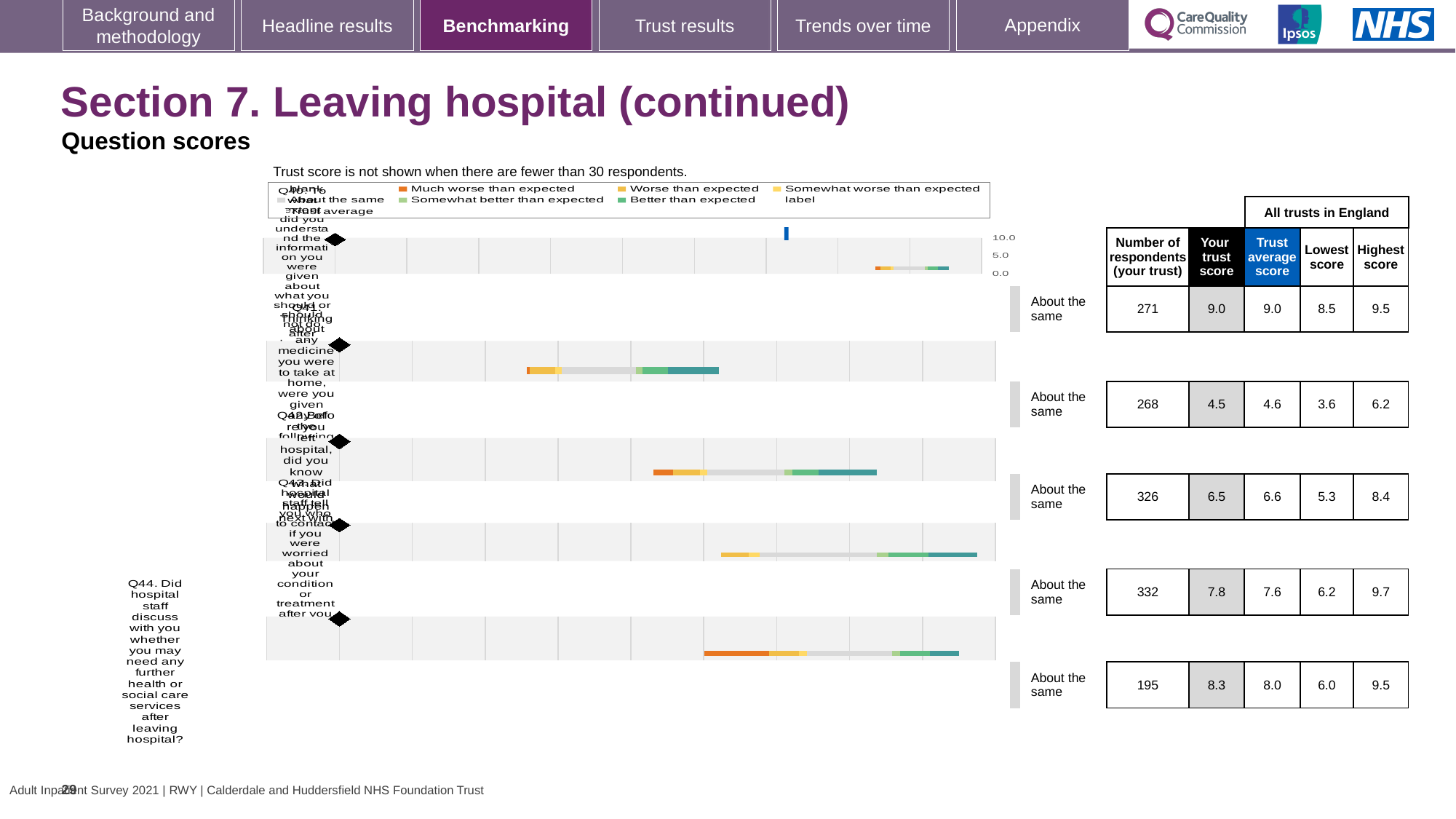
For Q44 (the bottom row), which is larger: 'Your trust score' or the 'Trust average score'? Your trust score How many question rows are plotted in the chart? 5 In the table, what is 'Your trust score' for Q44 (the bottom row)? 8.3 What is the smallest 'Your trust score' value shown in the table? 4.5 In the table, what is the 'Trust average score' for the top row (Q40)? 9.0 For Q44 (the bottom row), what is the difference between the 'Highest score' and the 'Lowest score'? 3.5 What kind of chart is shown on the slide? bar chart In the table, what is the number of respondents for Q44 (the bottom row)? 195 What heading spans the 'Trust average score', 'Lowest score' and 'Highest score' columns of the table? All trusts in England What benchmark category is shown next to every question row in the chart? About the same In the table, what is the 'Lowest score' for the second row? 3.6 What is the largest 'Number of respondents' value shown in the table? 332